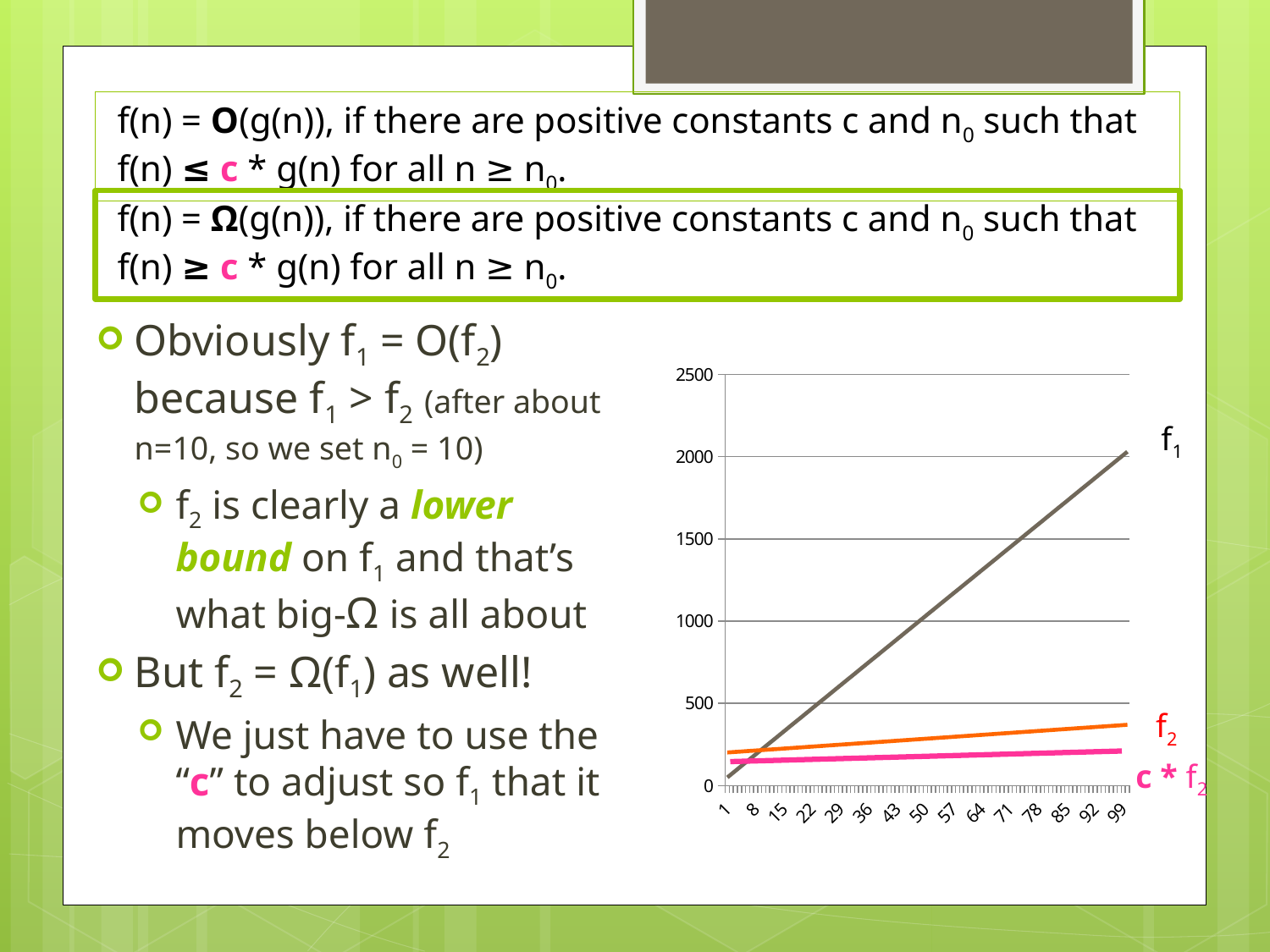
How many lines are plotted on the chart? 3 Which line is the lowest at the right end of the chart (n = 99)? c * f2 How many tick labels are shown on the x axis? 15 Is the value of f1 at n = 99 greater or less than 2500? less At n = 99, which is larger, f1 or f2? f1 Is the value of f1 at n = 99 greater or less than 1500? greater Which line reaches the highest value at the right end of the chart (n = 99)? f1 Is the value of f1 at n = 22 greater or less than 1000? less Does the f1 line rise or fall as n increases along the x axis? rises What kind of chart is shown on the slide? line chart What is the highest value labelled on the y axis? 2500